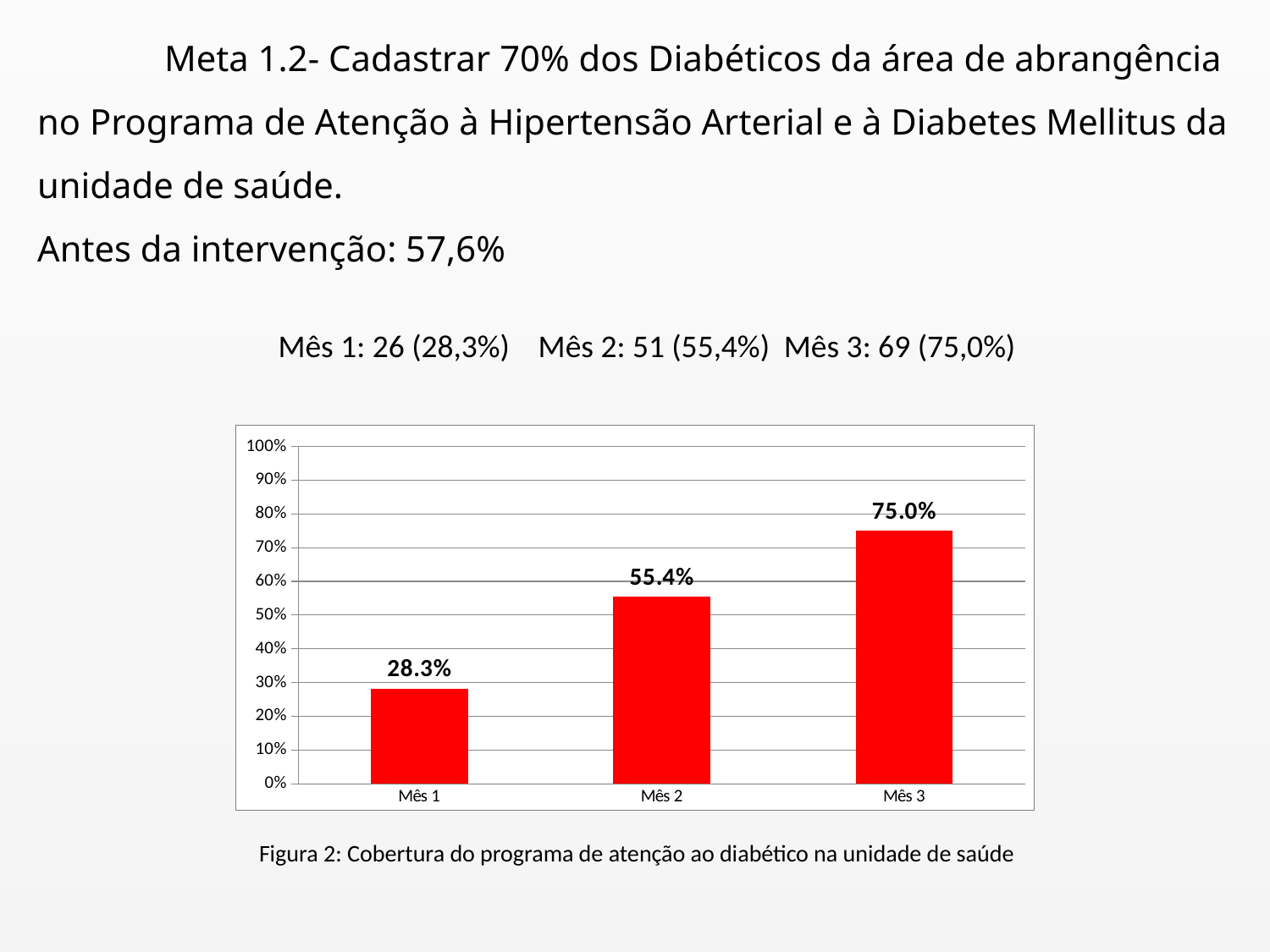
Which month has the lowest value? Mês 1 What is the value for Mês 1? 28.3% What kind of chart is shown on the slide? bar chart Is the value for Mês 2 greater or less than 50%? greater Which is larger, the value for Mês 2 or the value for Mês 3? Mês 3 What is the value for Mês 2? 55.4% What is the value for Mês 3? 75.0% Which month has the highest value? Mês 3 What is the difference between the values for Mês 3 and Mês 1? 46.7% Do the values rise or fall from Mês 1 to Mês 3? rise What is the difference between the values for Mês 2 and Mês 1? 27.1% How many categories are shown on the x axis? 3